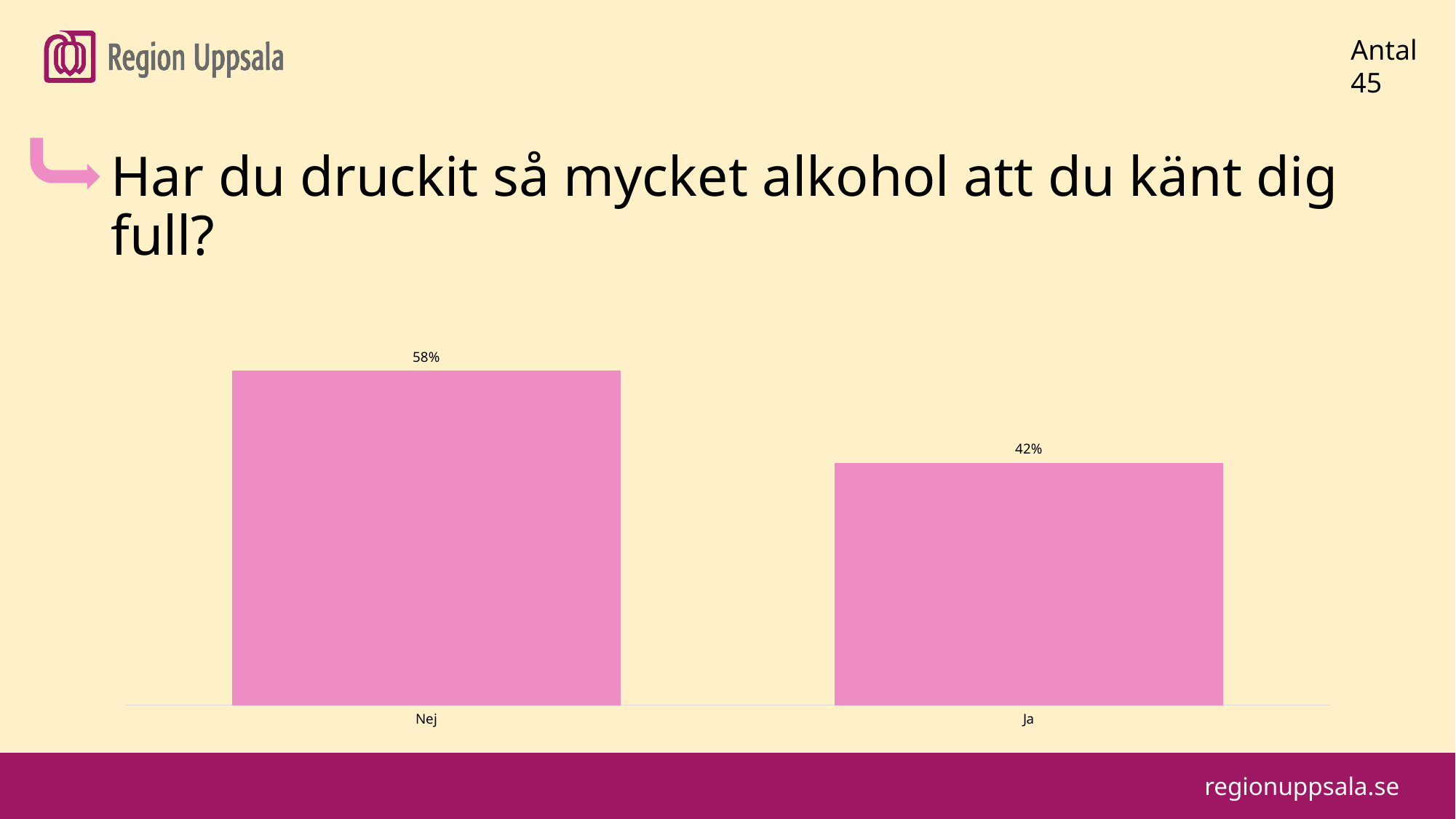
What kind of chart is shown on the slide? bar chart What is the value for Nej? 58% What is the difference between the values for Nej and Ja? 16% What is the total of the two bar values? 100% Which is larger, the value for Nej or the value for Ja? Nej What colour are the bars in the chart? pink How many categories are shown in the chart? 2 What question does the chart on the slide answer? Har du druckit så mycket alkohol att du känt dig full? Which category has the lowest value? Ja Which category has the highest value? Nej What is the value for Ja? 42%